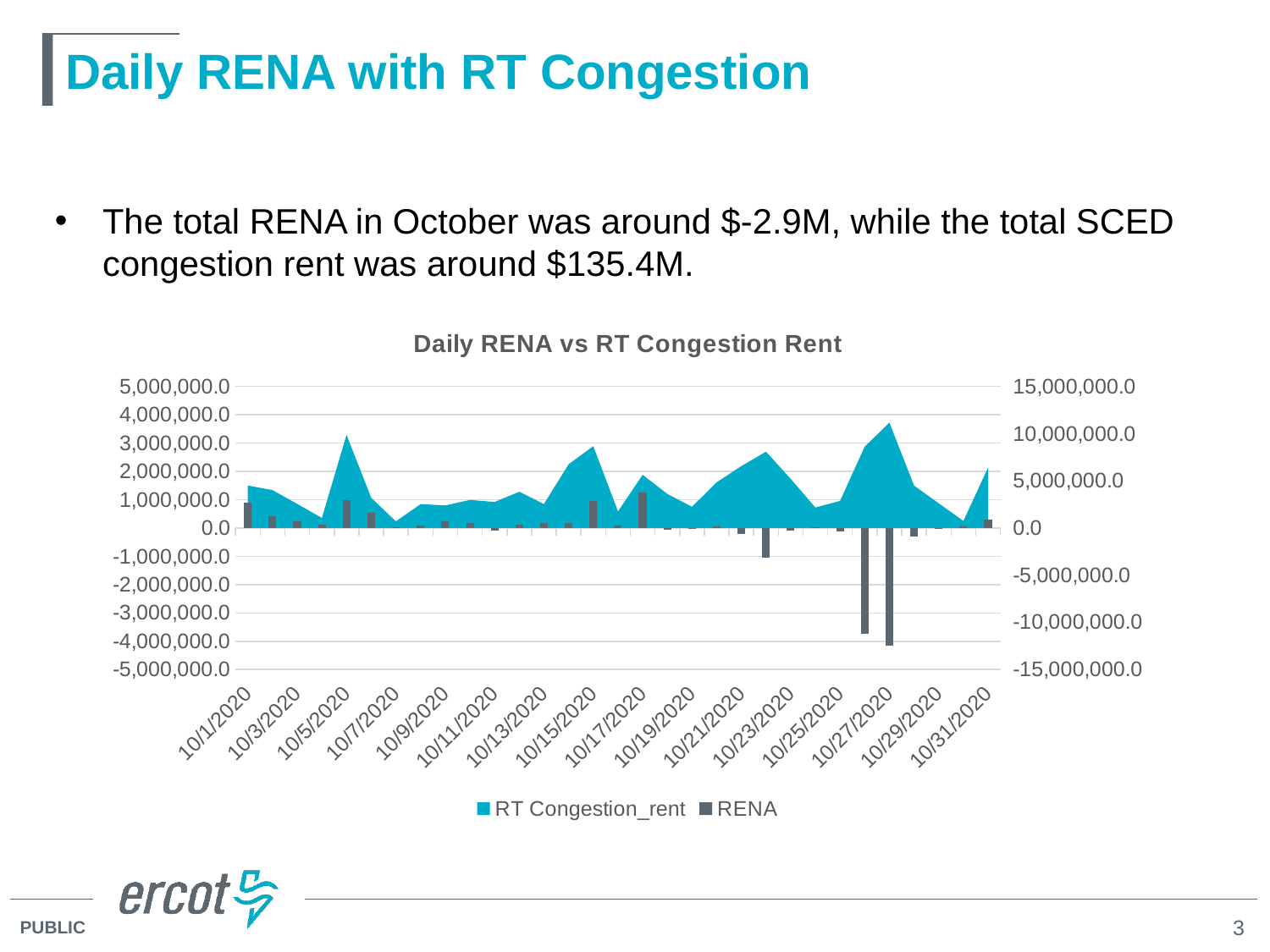
Does the RT Congestion_rent area rise or fall from 10/25/2020 to 10/27/2020? rise Is the RENA value on 10/27/2020 greater or less than -3,000,000.0 on the left axis? less What kind of chart is used for the RENA series? bar chart How many series does the chart legend list? 2 Which series is drawn as bars in the chart? RENA Is the RT Congestion_rent value higher on 10/5/2020 or on 10/7/2020? 10/5/2020 How many date labels are shown on the x axis? 16 What is the title of the chart? Daily RENA vs RT Congestion Rent On which date does the RT Congestion_rent area reach its highest point? 10/27/2020 On which date is the RENA bar lowest (most negative)? 10/27/2020 What is the highest value shown on the right-hand axis? 15,000,000.0 Is the RT Congestion_rent value on 10/27/2020 greater or less than 5,000,000.0 on the right axis? greater